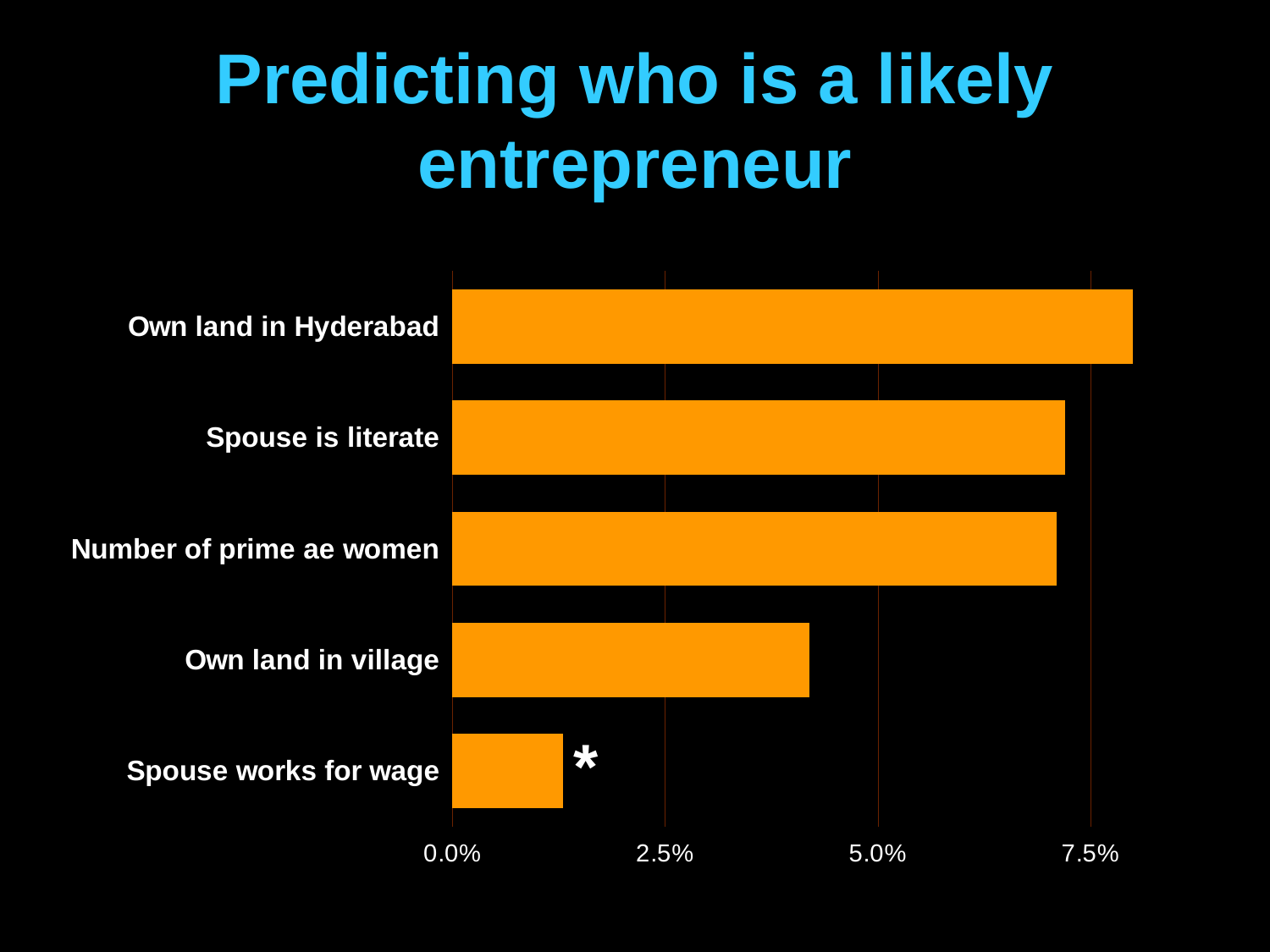
Which category's bar is marked with an asterisk? Spouse works for wage Is the value for Spouse is literate greater or less than 5.0%? greater Which category has the highest value in the chart? Own land in Hyderabad What is the title of the slide containing the chart? Predicting who is a likely entrepreneur Which category has the lowest value in the chart? Spouse works for wage What kind of chart is shown on the slide? bar chart How many categories are plotted in the chart? 5 Is the value for Own land in Hyderabad greater or less than 7.5%? greater Is the value for Own land in village greater or less than 5.0%? less Which is larger, the value for Own land in village or the value for Spouse works for wage? Own land in village